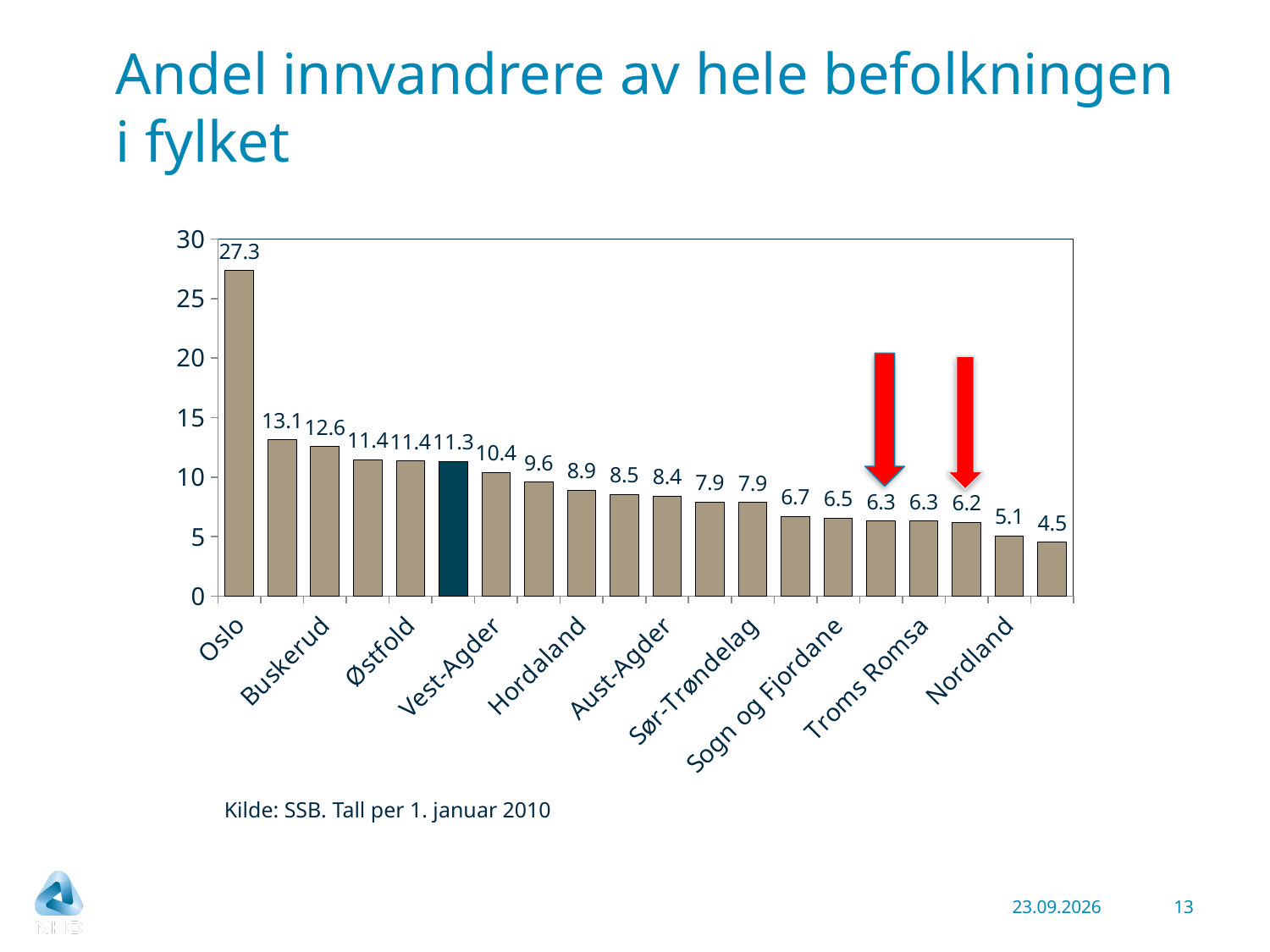
What type of chart is shown on the slide? bar chart Do the values rise or fall from left to right along the x axis? fall What is the value for Buskerud? 12.6 What is the value for Oslo? 27.3 What is the value for Nordland? 5.1 What is the lowest value shown in the chart? 4.5 Is the value for Oslo greater or less than 25? greater What is the value for Vest-Agder? 10.4 How many bars are plotted in the chart? 20 What is the difference between the values for Oslo and Buskerud? 14.7 Which has a larger value, Hordaland or Sør-Trøndelag? Hordaland Which county has the highest share of immigrants? Oslo